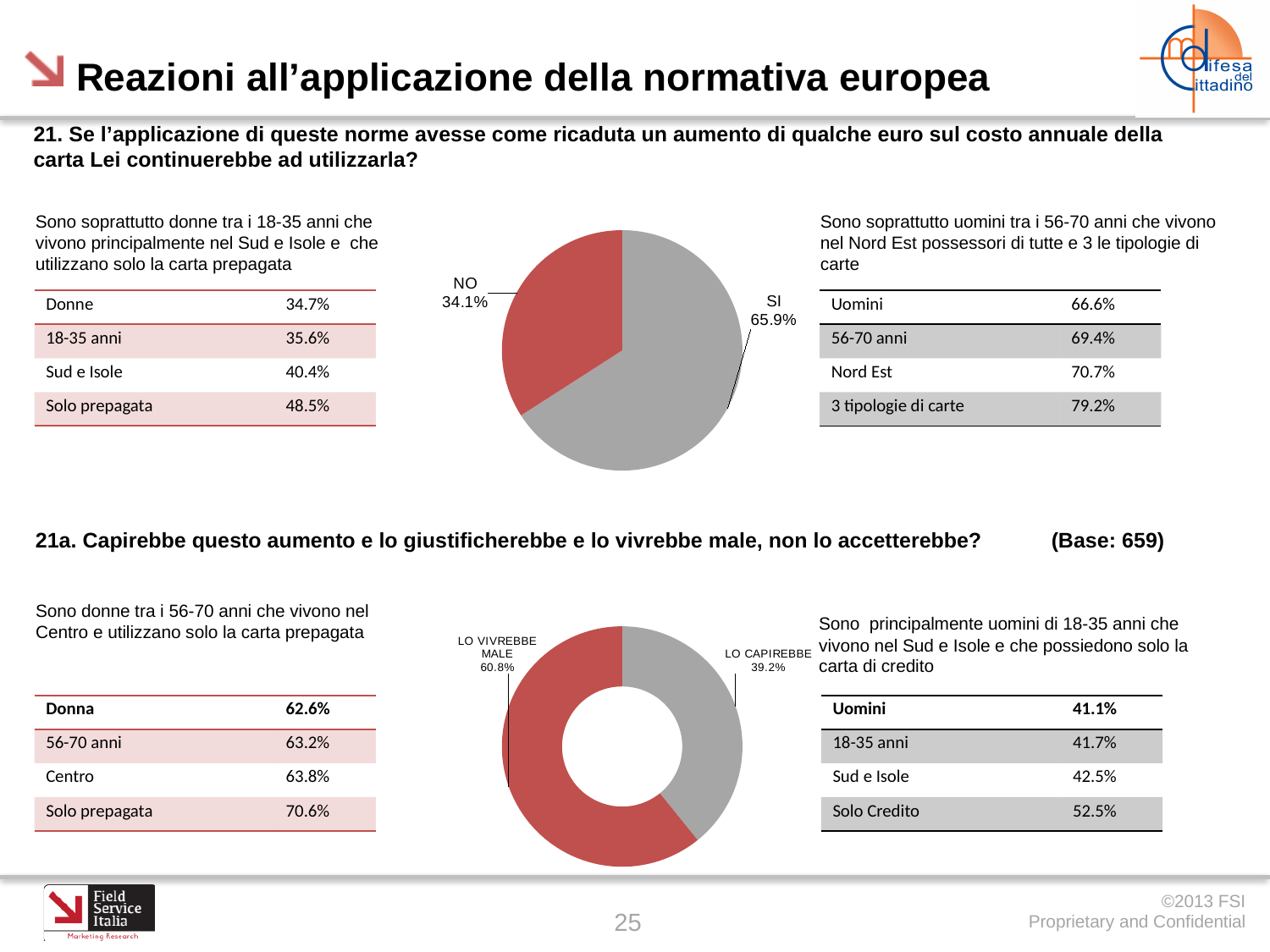
In the top pie chart, what is the value for NO? 34.1% In the top pie chart, how many slices are there? 2 In the top pie chart, what is the value for SI? 65.9% What kind of chart is the bottom chart on the slide? Doughnut chart In the top pie chart, which slice is the largest? SI In the top pie chart, what is the difference between the SI and NO values? 31.8% In the bottom doughnut chart, which is larger, LO VIVREBBE MALE or LO CAPIREBBE? LO VIVREBBE MALE In the bottom doughnut chart, what is the difference between LO VIVREBBE MALE and LO CAPIREBBE? 21.6% In the bottom doughnut chart, what is the value for LO VIVREBBE MALE? 60.8% In the bottom doughnut chart, what is the value for LO CAPIREBBE? 39.2% In the bottom doughnut chart, which slice is the smallest? LO CAPIREBBE What kind of chart is the top chart on the slide? Pie chart